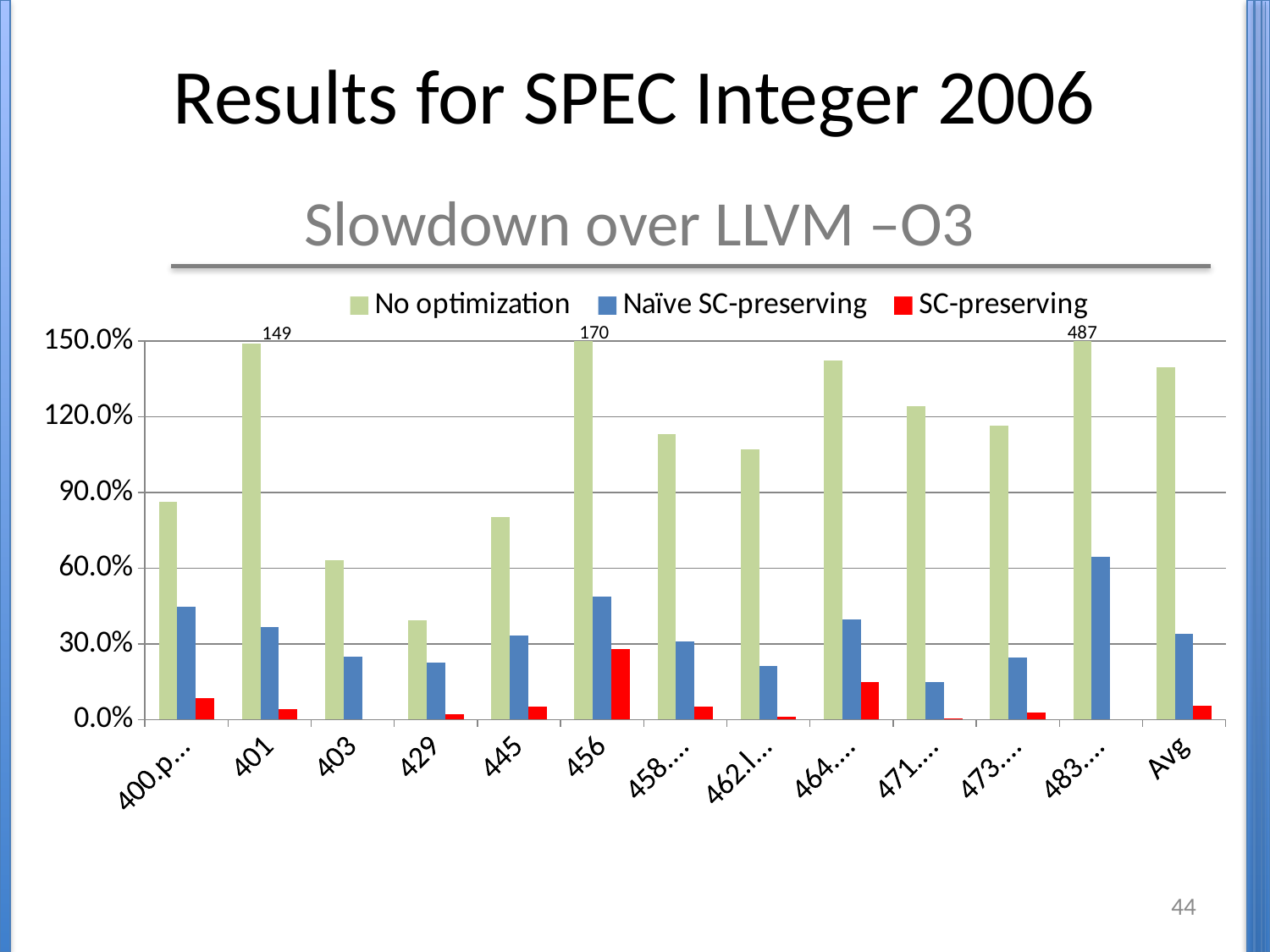
How many categories are plotted along the x axis of the chart? 13 What are the three series named in the chart legend? No optimization, Naïve SC-preserving, SC-preserving Is the No optimization value for 445 greater or less than 90.0%? less What data label is printed above the No optimization bar for 401? 149 Which category has the highest SC-preserving value? 456 What is the title of the chart? Slowdown over LLVM –O3 Is the Naïve SC-preserving value for Avg greater or less than 60.0%? less What data label is printed above the No optimization bar for 456? 170 How many series does the chart legend list? 3 What kind of chart is shown on the slide? bar chart Is the No optimization value for 429 greater or less than 30.0%? greater Which is larger, the SC-preserving value for 456 or for 401? 456